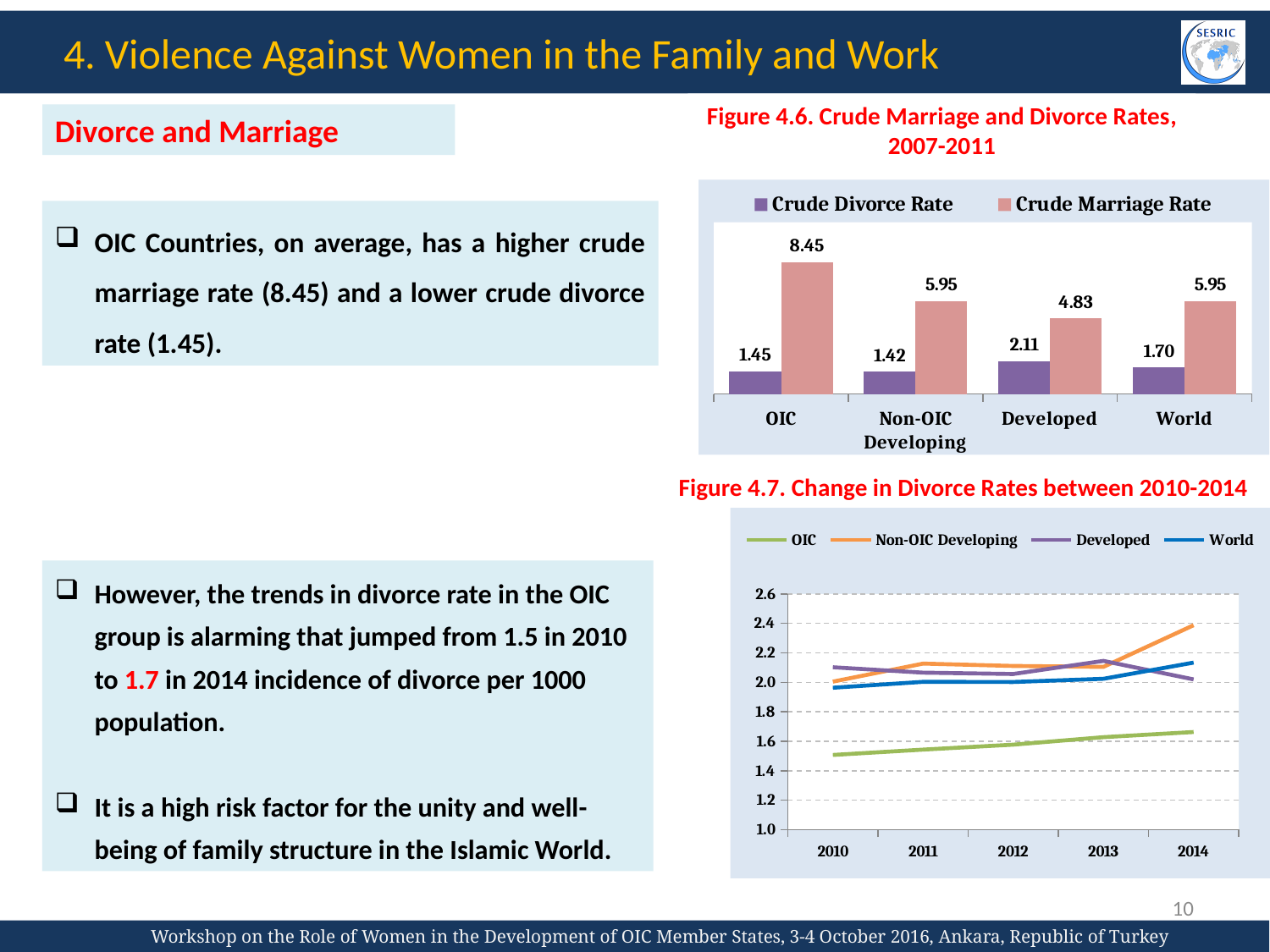
In Figure 4.7, how many series does the legend list? 4 In Figure 4.6, which category has the highest Crude Divorce Rate? Developed In Figure 4.6, how many series does the legend list? 2 What kind of chart is Figure 4.6? Bar chart In Figure 4.6, which category has the lowest Crude Marriage Rate? Developed In Figure 4.6, is the Crude Divorce Rate higher for World or for Non-OIC Developing? World In Figure 4.6, what is the Crude Divorce Rate for Developed? 2.11 In Figure 4.7, is the value for Non-OIC Developing in 2014 greater or less than 2.2? greater In Figure 4.6, what is the Crude Marriage Rate for OIC? 8.45 In Figure 4.7, does the OIC divorce rate rise or fall from 2010 to 2014? Rise In Figure 4.6, how many categories are shown on the x axis? 4 In Figure 4.6, what is the difference between the Crude Marriage Rate and the Crude Divorce Rate for OIC? 7.00